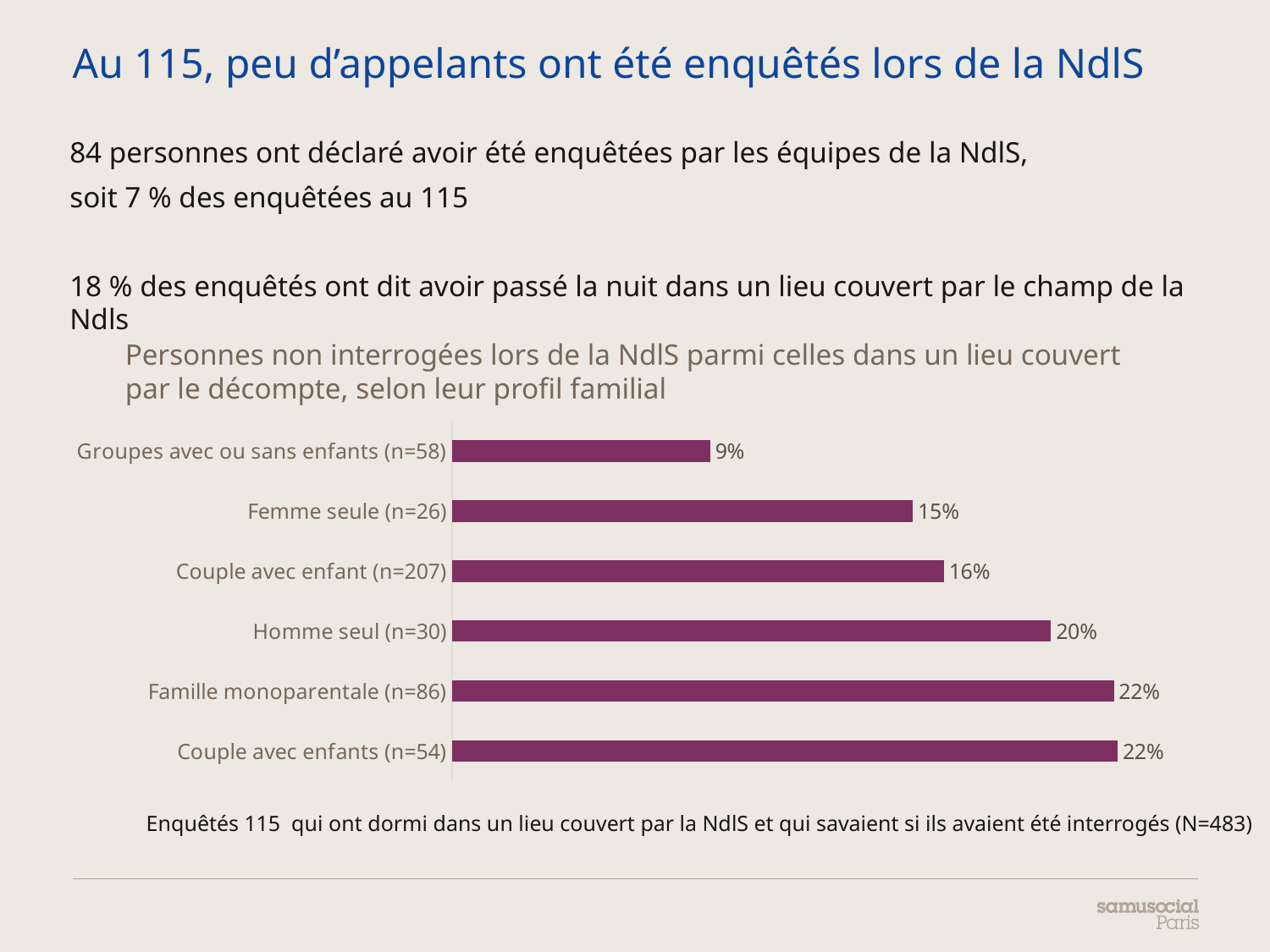
What is the title of the chart? Personnes non interrogées lors de la NdlS parmi celles dans un lieu couvert par le décompte, selon leur profil familial Which is larger, the value for Couple avec enfants (n=54) or the value for Couple avec enfant (n=207)? Couple avec enfants (n=54) What is the value for Famille monoparentale (n=86)? 22% What type of chart is shown on the slide? bar chart What is the value for Couple avec enfant (n=207)? 16% What is the value for Homme seul (n=30)? 20% What is the difference between the values for Couple avec enfants (n=54) and Groupes avec ou sans enfants (n=58)? 13% How many categories are shown in the chart? 6 What is the value for Groupes avec ou sans enfants (n=58)? 9% Which category has the lowest value? Groupes avec ou sans enfants (n=58) What is the difference between the values for Homme seul (n=30) and Femme seule (n=26)? 5% What is the value for Femme seule (n=26)? 15%